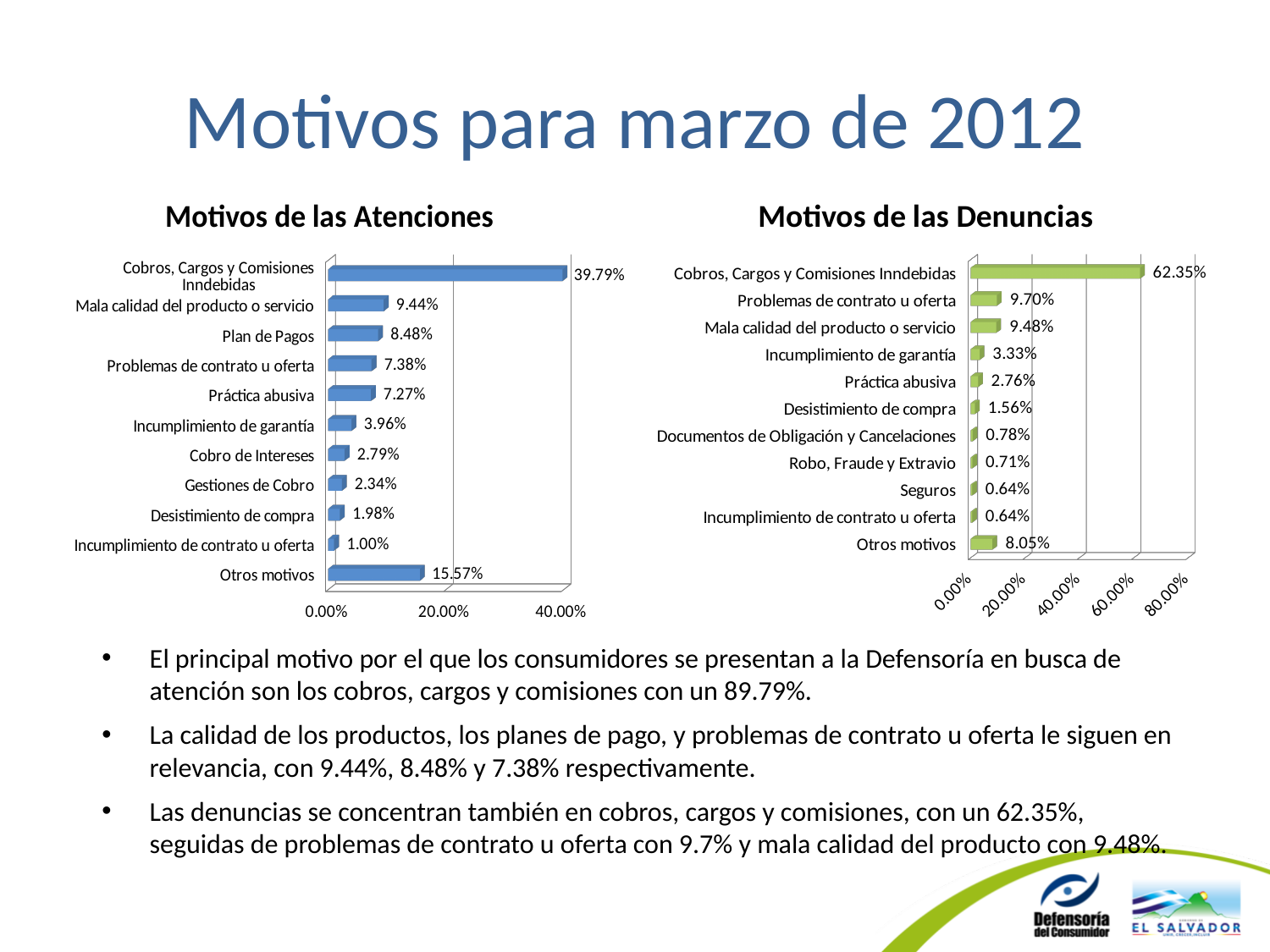
How many categories are shown in the 'Motivos de las Atenciones' chart? 11 In the 'Motivos de las Denuncias' chart, is the value for Cobros, Cargos y Comisiones Inndebidas greater or less than 60.00%? greater What is the title of the chart on the right side of the slide? Motivos de las Denuncias In the 'Motivos de las Atenciones' chart, what is the difference between Práctica abusiva and Incumplimiento de garantía? 3.31% In the 'Motivos de las Denuncias' chart, what is the difference between Cobros, Cargos y Comisiones Inndebidas and Problemas de contrato u oferta? 52.65% In the 'Motivos de las Atenciones' chart, what is the value for Plan de Pagos? 8.48% In the 'Motivos de las Atenciones' chart, which category has the highest value? Cobros, Cargos y Comisiones Inndebidas What kind of chart is 'Motivos de las Denuncias'? Bar chart In the 'Motivos de las Atenciones' chart, which category has the lowest value? Incumplimiento de contrato u oferta In the 'Motivos de las Denuncias' chart, what is the value for Problemas de contrato u oferta? 9.70% In the 'Motivos de las Atenciones' chart, which is larger: Mala calidad del producto o servicio or Otros motivos? Otros motivos In the 'Motivos de las Denuncias' chart, what is the value for Otros motivos? 8.05%